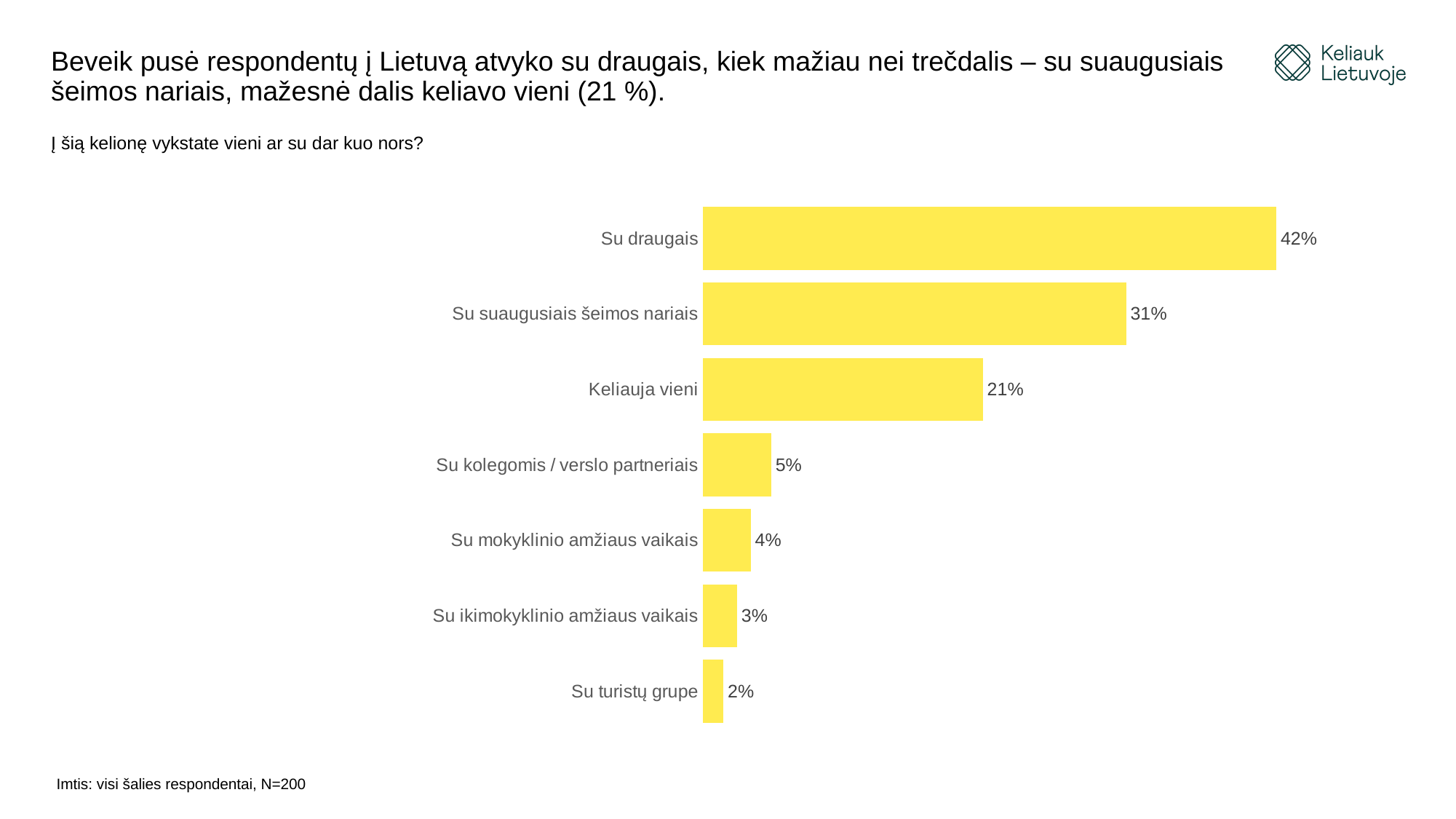
What kind of chart is shown on the slide? Bar chart Which category has the highest value? Su draugais What is the value for Su draugais? 42% Which category has the lowest value? Su turistų grupe What is the value for Su kolegomis / verslo partneriais? 5% What is the difference between the values for Su draugais and Su suaugusiais šeimos nariais? 11% How many categories are shown in the chart? 7 Which is larger, the value for Su mokyklinio amžiaus vaikais or Su ikimokyklinio amžiaus vaikais? Su mokyklinio amžiaus vaikais What is the value for Keliauja vieni? 21% What is the value for Su suaugusiais šeimos nariais? 31% What is the sample size stated at the bottom of the slide? N=200 What is the value for Su turistų grupe? 2%